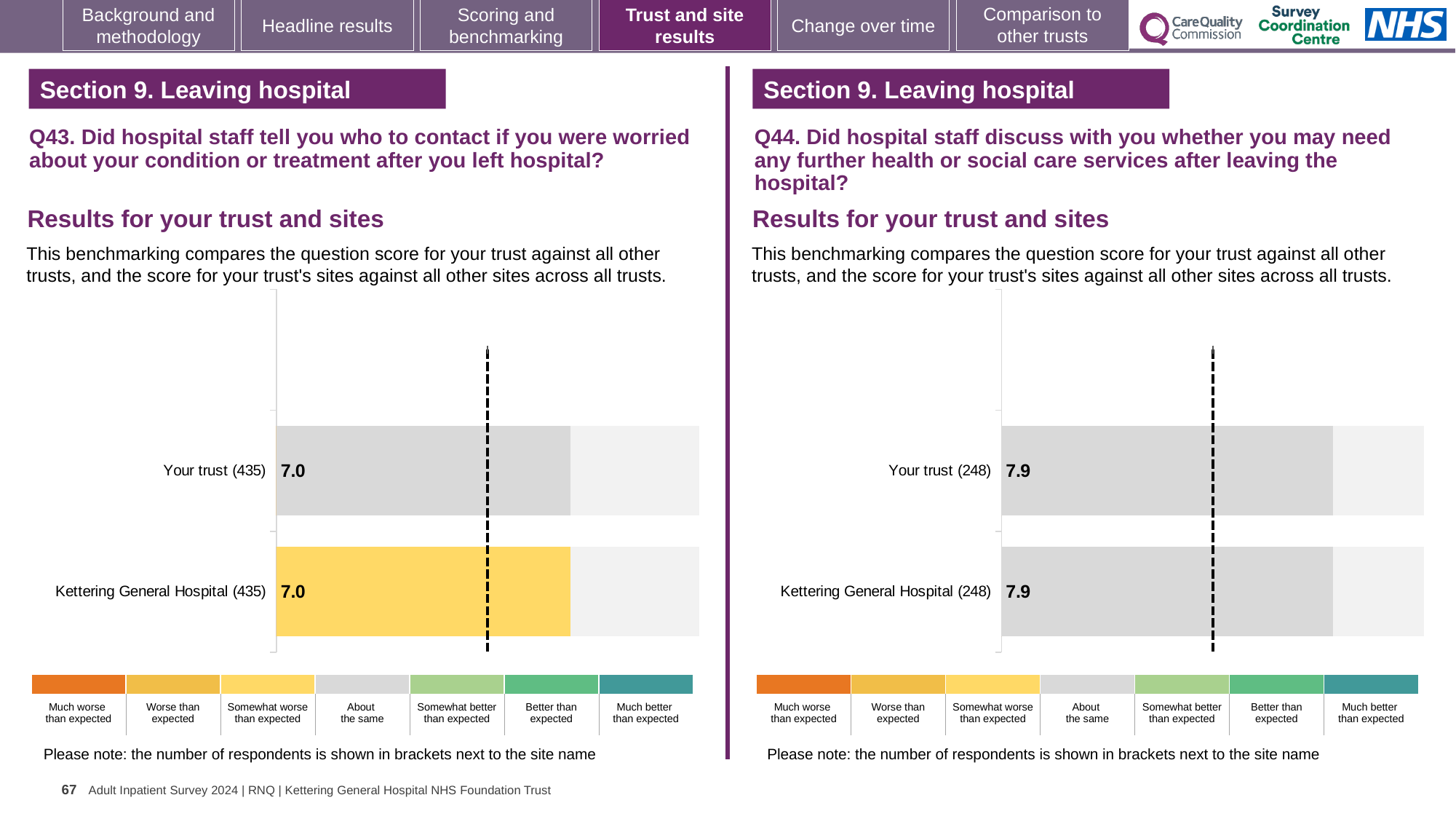
On the Q43 chart (left), how many respondents are shown in brackets for Kettering General Hospital? 435 On the Q43 chart (left), what is the difference between the score for Your trust and the score for Kettering General Hospital? 0.0 On the Q44 chart (right), what is the score for Your trust? 7.9 What kind of chart is the Q43 chart (left)? Bar chart How many bars are plotted on the Q44 chart (right)? 2 How many bars are plotted on the Q43 chart (left)? 2 Is the score for Your trust on the Q44 chart (right) larger or smaller than the score for Your trust on the Q43 chart (left)? Larger On the Q44 chart (right), what is the difference between the score for Your trust and the score for Kettering General Hospital? 0.0 On the Q43 chart (left), what is the score for Kettering General Hospital? 7.0 On the Q43 chart (left), what is the score for Your trust? 7.0 On the Q44 chart (right), how many respondents are shown in brackets for Your trust? 248 On the Q44 chart (right), what is the score for Kettering General Hospital? 7.9